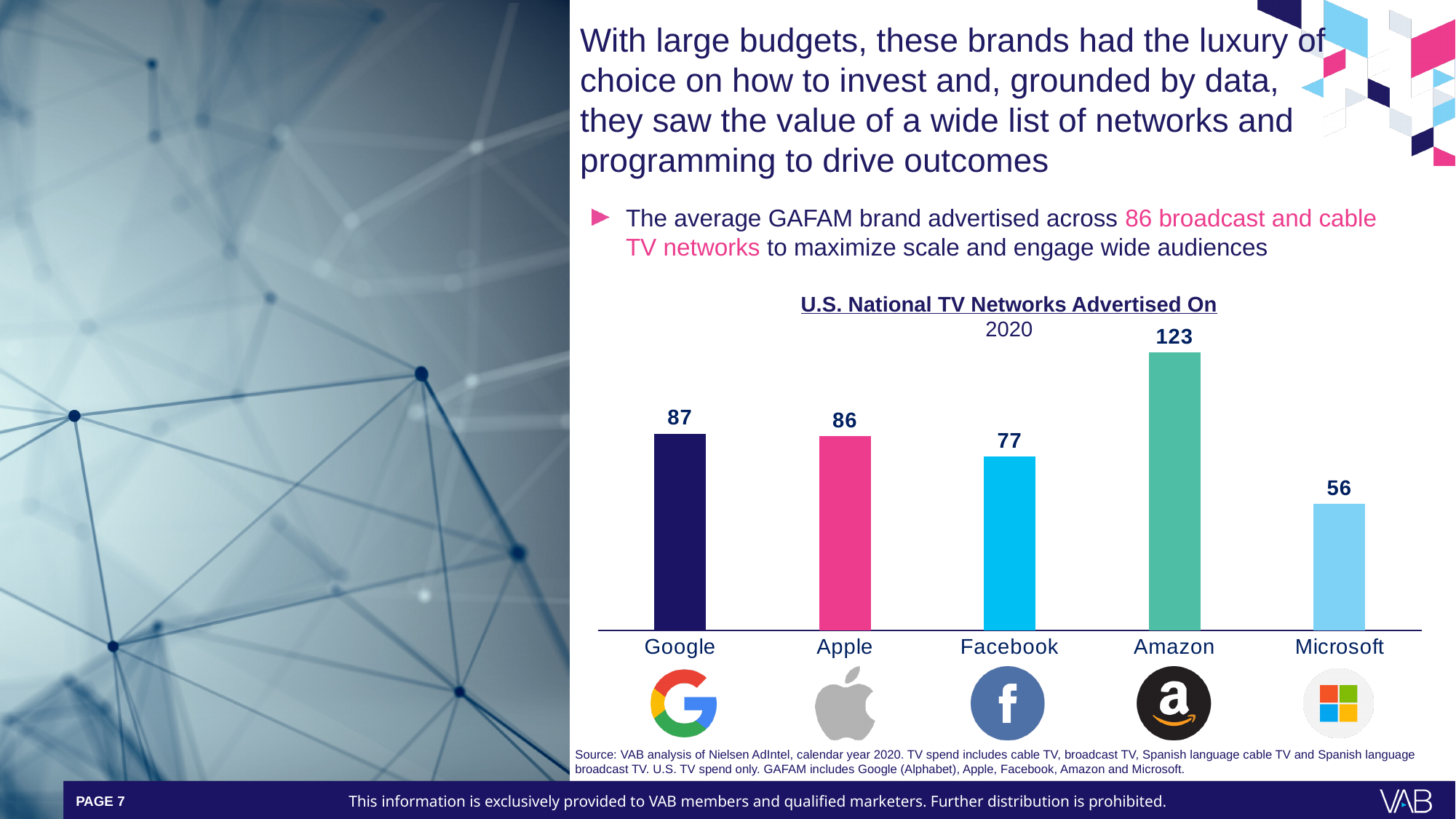
What is the value shown for Amazon? 123 What colour is the bar for Apple? Pink What kind of chart is shown on the slide? Bar chart What is the difference between Amazon's and Microsoft's values? 67 What is the value shown for Microsoft? 56 How many brands are shown in the chart? 5 Which brand advertised on the fewest U.S. national TV networks? Microsoft How many U.S. national TV networks did Google advertise on in 2020? 87 Which is larger, the value for Facebook or the value for Microsoft? Facebook Which brand advertised on the most U.S. national TV networks? Amazon What is the difference between Google's and Facebook's values? 10 What is the title of the chart? U.S. National TV Networks Advertised On